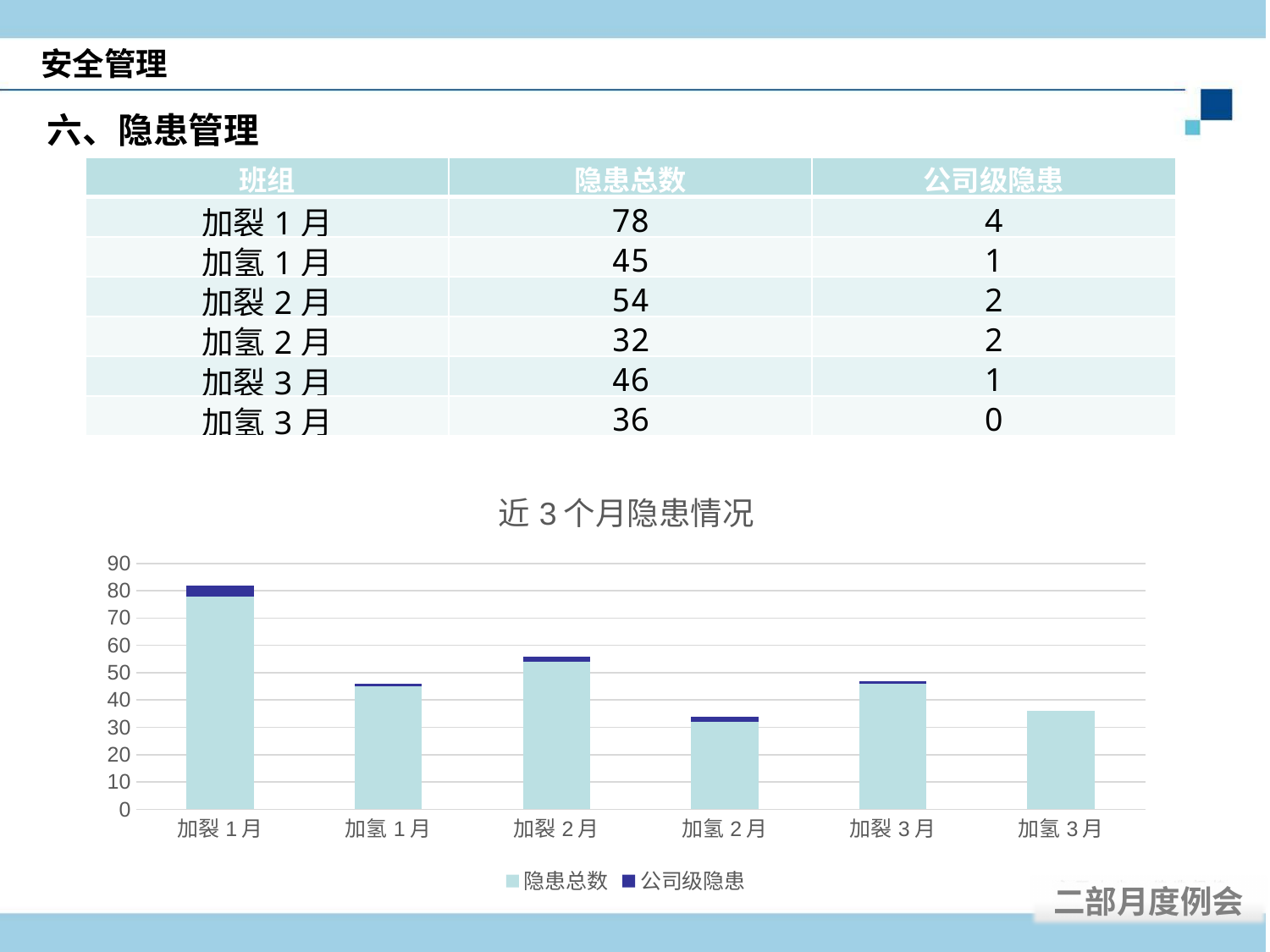
What is the 公司级隐患 value for 加裂 1 月? 4 What is the 隐患总数 value for 加裂 2 月? 54 What is the title of the chart? 近 3 个月隐患情况 How many series does the chart legend list? 2 What is the difference in 隐患总数 between 加裂 1 月 and 加氢 1 月? 33 What type of chart is shown under the title 近3个月隐患情况? bar chart Is the stacked bar for 加裂 1 月 greater or less than 80? greater Is the 隐患总数 bar for 加氢 3 月 greater or less than 40? less Which category has the highest 隐患总数 in the chart? 加裂 1 月 What is the total height of the stacked bar for 加裂 1 月 (隐患总数 plus 公司级隐患)? 82 Which category has the lowest 隐患总数 in the chart? 加氢 2 月 How many categories are shown on the x axis of the chart? 6